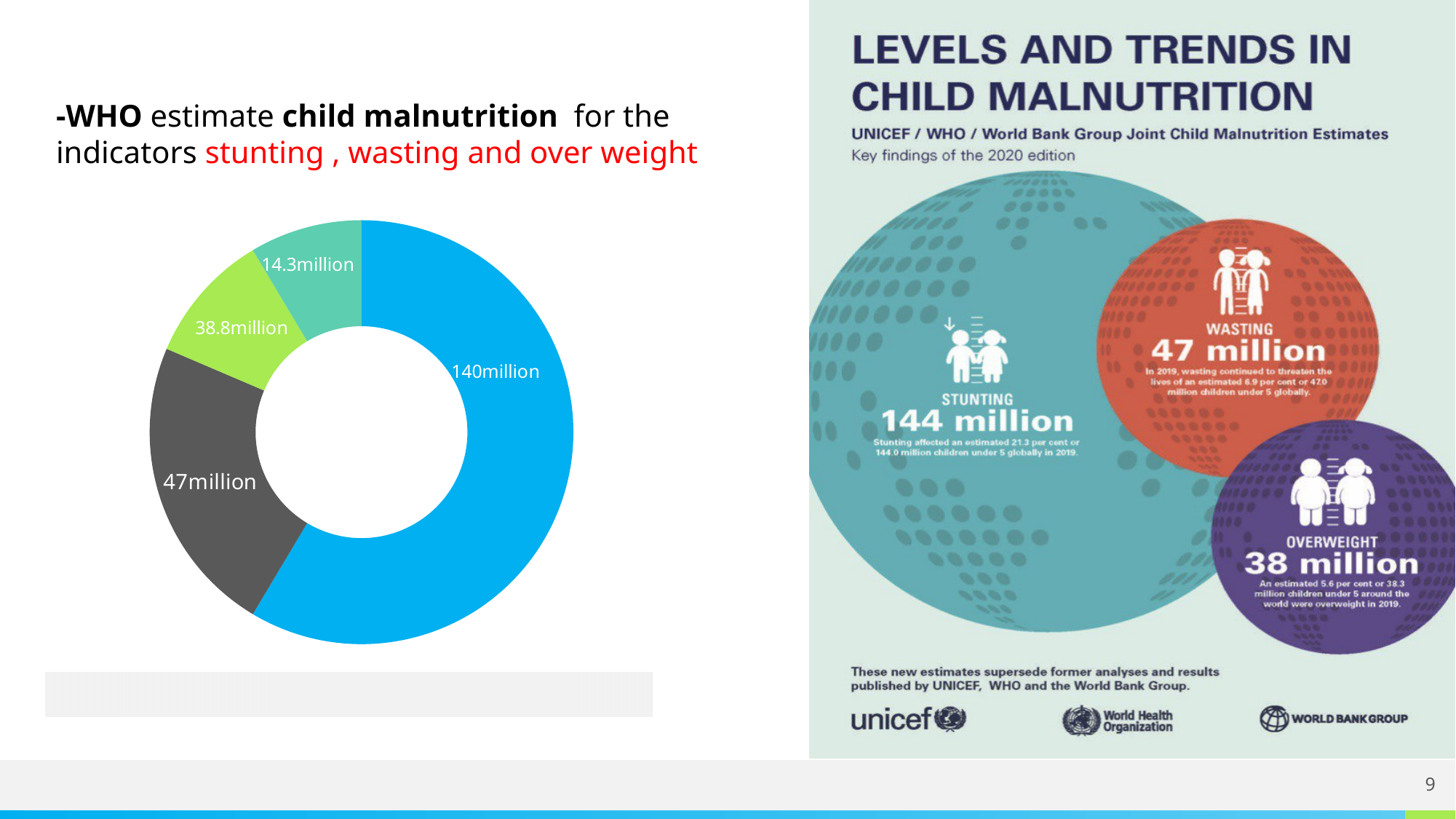
In the doughnut chart, what is the difference between the 38.8million slice and the 14.3million slice? 24.5million What value is labelled on the teal slice of the doughnut chart? 14.3million What value is labelled on the green slice of the doughnut chart? 38.8million How many slices does the doughnut chart on the left have? 4 In the doughnut chart, what is the difference between the 140million slice and the 47million slice? 93million What value is labelled on the dark grey slice of the doughnut chart? 47million What value is labelled on the blue slice of the doughnut chart? 140million What is the value shown on the smallest slice of the doughnut chart? 14.3million What kind of chart is shown on the left of the slide? Doughnut (pie) chart What colour is the largest slice of the doughnut chart? Blue What is the value shown on the largest slice of the doughnut chart? 140million In the doughnut chart, which slice is larger: the blue slice or the dark grey slice? The blue slice